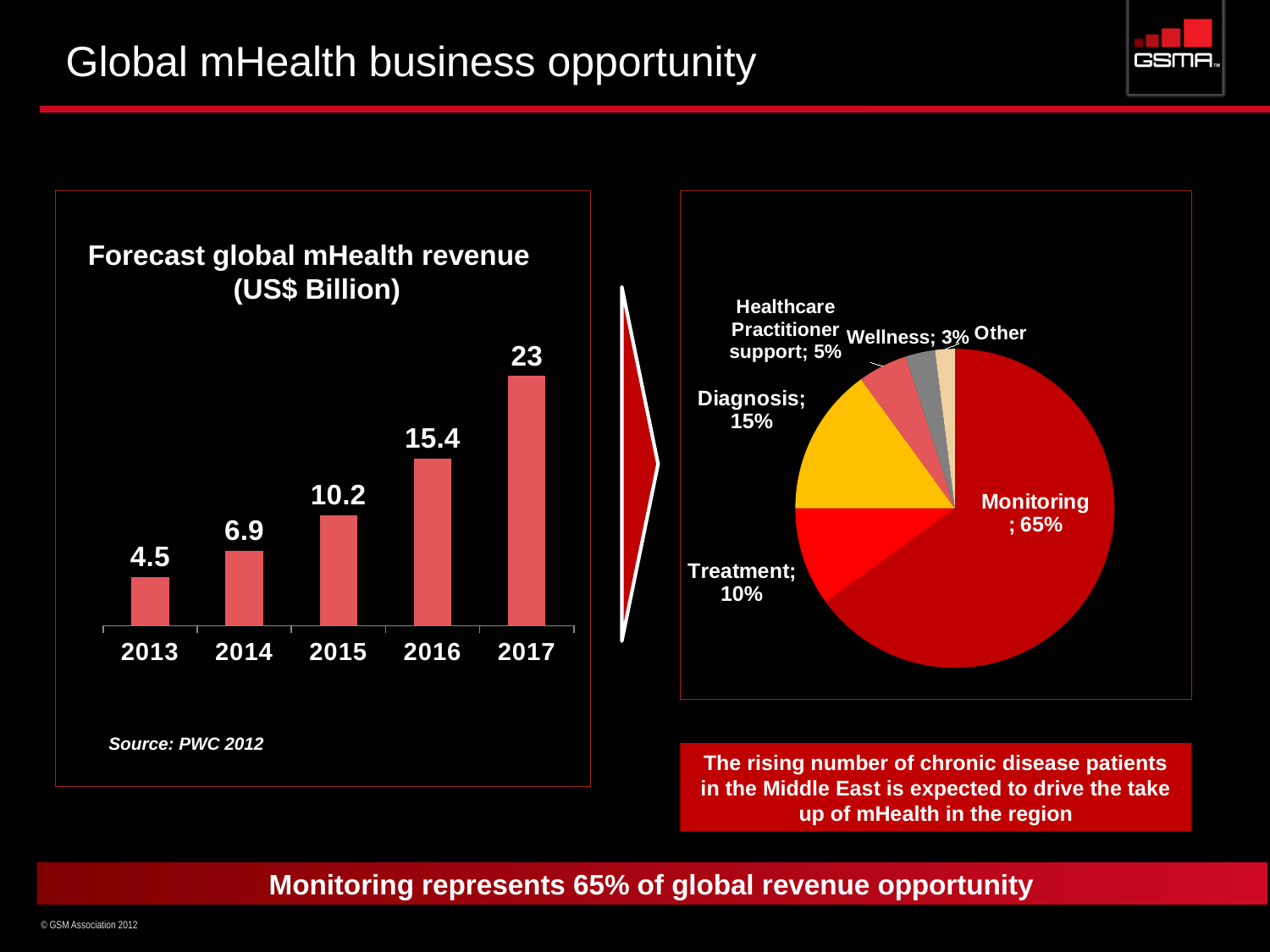
In the bar chart titled "Forecast global mHealth revenue (US$ Billion)", do the values rise or fall from 2013 to 2017? rise What kind of chart is the chart on the left of the slide? bar chart What kind of chart is the chart on the right of the slide? pie chart In the bar chart titled "Forecast global mHealth revenue (US$ Billion)", what is the value for 2017? 23 In the bar chart titled "Forecast global mHealth revenue (US$ Billion)", which year has the lowest value? 2013 How many years are shown in the bar chart titled "Forecast global mHealth revenue (US$ Billion)"? 5 In the bar chart titled "Forecast global mHealth revenue (US$ Billion)", which year has the highest value? 2017 In the pie chart on the right of the slide, what share does Monitoring represent? 65% In the bar chart titled "Forecast global mHealth revenue (US$ Billion)", what is the difference between the values for 2016 and 2014? 8.5 In the pie chart on the right of the slide, which is larger: Treatment or Healthcare Practitioner support? Treatment In the bar chart titled "Forecast global mHealth revenue (US$ Billion)", what is the value for 2015? 10.2 In the pie chart on the right of the slide, what share does Diagnosis represent? 15%